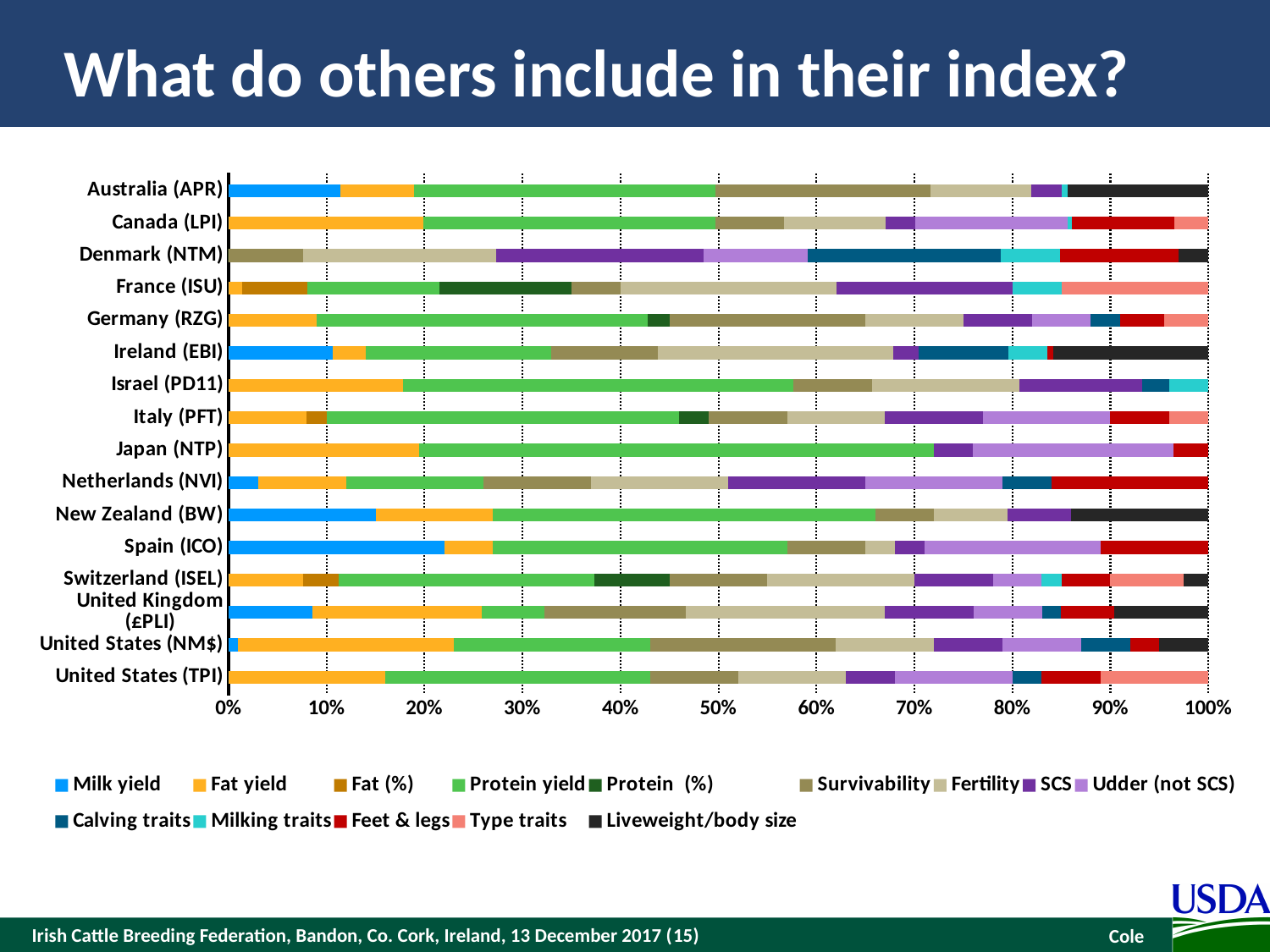
How many indices (categories) are listed on the vertical axis of the chart? 16 Which has a larger Milk yield share, Australia (APR) or Netherlands (NVI)? Australia (APR) What is the maximum value shown on the horizontal axis of the chart? 100% Is the Milk yield share for New Zealand (BW) greater or less than 20%? less What kind of chart is shown on the slide? Stacked bar chart Is the Milk yield share for Spain (ICO) greater or less than 20%? greater Which index is listed first (at the top) of the chart? Australia (APR) How many series does the chart legend list? 14 Which index has the largest Milk yield share in the chart? Spain (ICO) What is the title of the slide containing the chart? What do others include in their index? Is the Milk yield share for Netherlands (NVI) greater or less than 10%? less Which has a larger Milk yield share, Spain (ICO) or New Zealand (BW)? Spain (ICO)